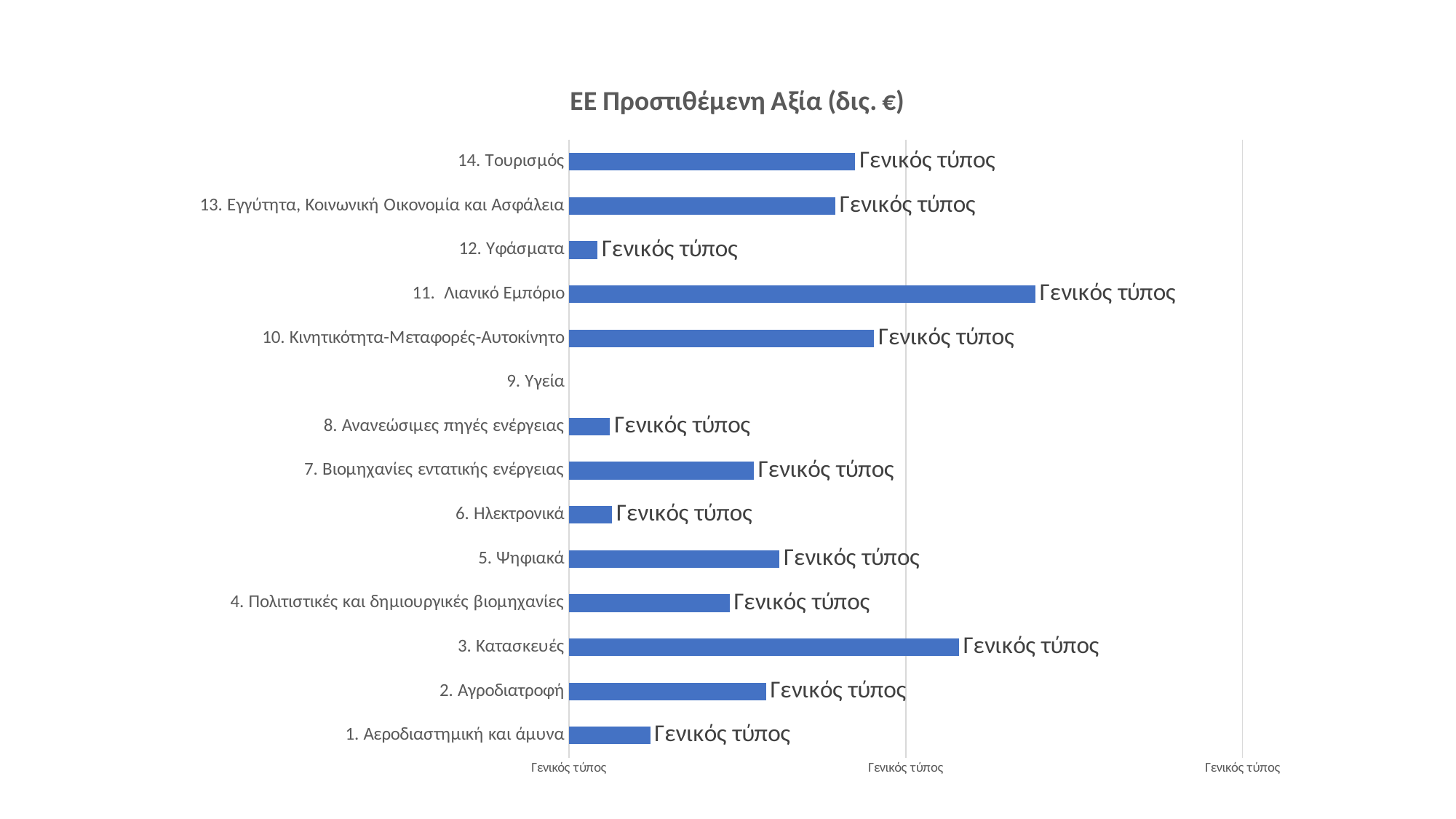
Which has the longer bar, 3. Κατασκευές or 14. Τουρισμός? 3. Κατασκευές Which category has the longest bar in the chart? 11. Λιανικό Εμπόριο What is the title of the chart? ΕΕ Προστιθέμενη Αξία (δις. €) Which has the longer bar, 1. Αεροδιαστημική και άμυνα or 12. Υφάσματα? 1. Αεροδιαστημική και άμυνα Which has the longer bar, 7. Βιομηχανίες εντατικής ενέργειας or 8. Ανανεώσιμες πηγές ενέργειας? 7. Βιομηχανίες εντατικής ενέργειας Which category has no visible bar in the chart? 9. Υγεία What kind of chart is shown on the slide? Bar chart How many categories are listed on the vertical axis of the chart? 14 What text do the data labels next to the bars display? Γενικός τύπος